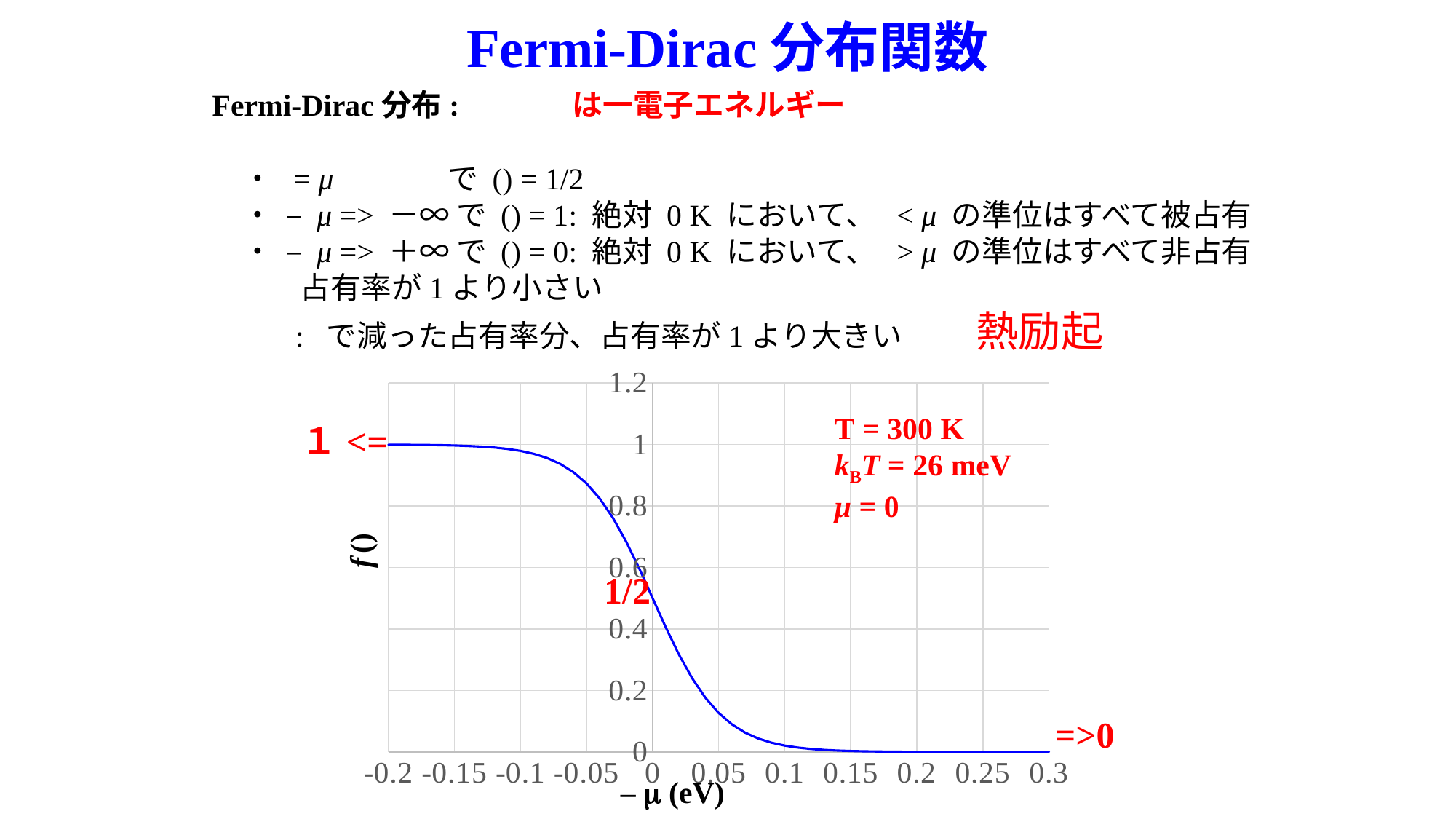
What is the maximum value shown on the y axis of the chart? 1.2 What is the label of the x axis of the chart? − μ (eV) Which is larger: the value of f(ε) at ε − μ = -0.1 eV or at ε − μ = 0.1 eV? -0.1 eV Is the value of f(ε) at ε − μ = 0.2 eV greater or less than 0.2? less Is the value of f(ε) at ε − μ = -0.1 eV greater or less than 0.8? greater What temperature T is annotated on the chart? T = 300 K What kind of chart is shown on the slide? line chart Does the plotted value rise or fall as ε − μ increases along the x axis? fall What is the value of f(ε) at ε − μ = 0, as annotated on the chart? 1/2 Is the value of f(ε) at ε − μ = 0.1 eV greater or less than 0.2? less What is the minimum value shown on the x axis of the chart? -0.2